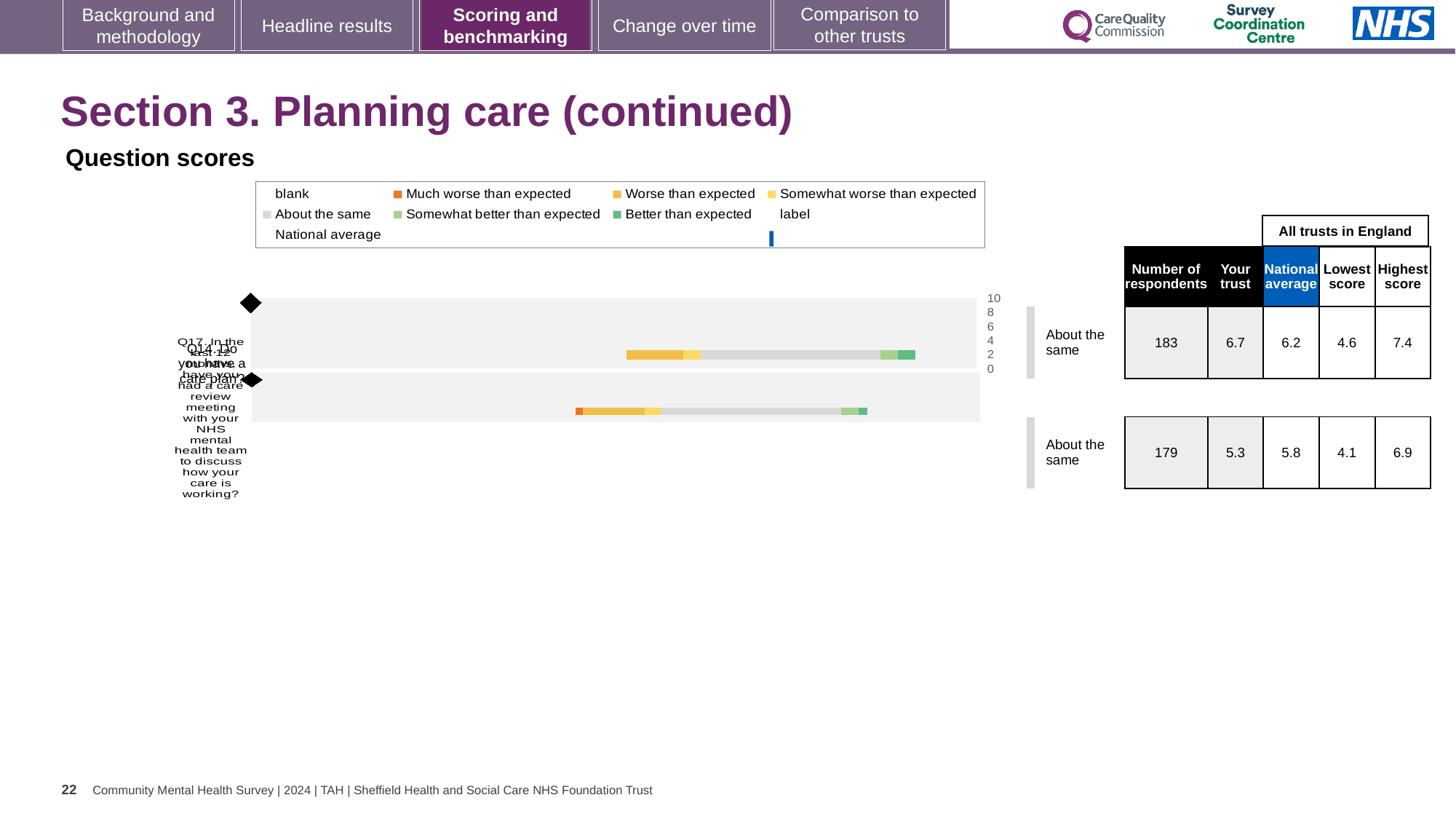
What is the difference between the 'Your trust' score and the 'National average' score for the second question row (Q17)? 0.5 What is the 'National average' score for the first question row in the table? 6.2 What is the highest score across all trusts in England for the first question row? 7.4 What kind of chart is shown under 'Question scores'? bar chart How many respondents answered the second question row (Q17)? 179 What is the 'National average' score for the second question row (Q17) in the table? 5.8 For the first question row, is the 'Your trust' score or the 'National average' score larger? Your trust What is the 'Your trust' score for the second question row (Q17) in the table? 5.3 What is the 'Your trust' score for the first question row in the table? 6.7 How many question bars are plotted in the chart? 2 How many respondents answered the first question row? 183 What is the lowest score across all trusts in England for the second question row (Q17)? 4.1